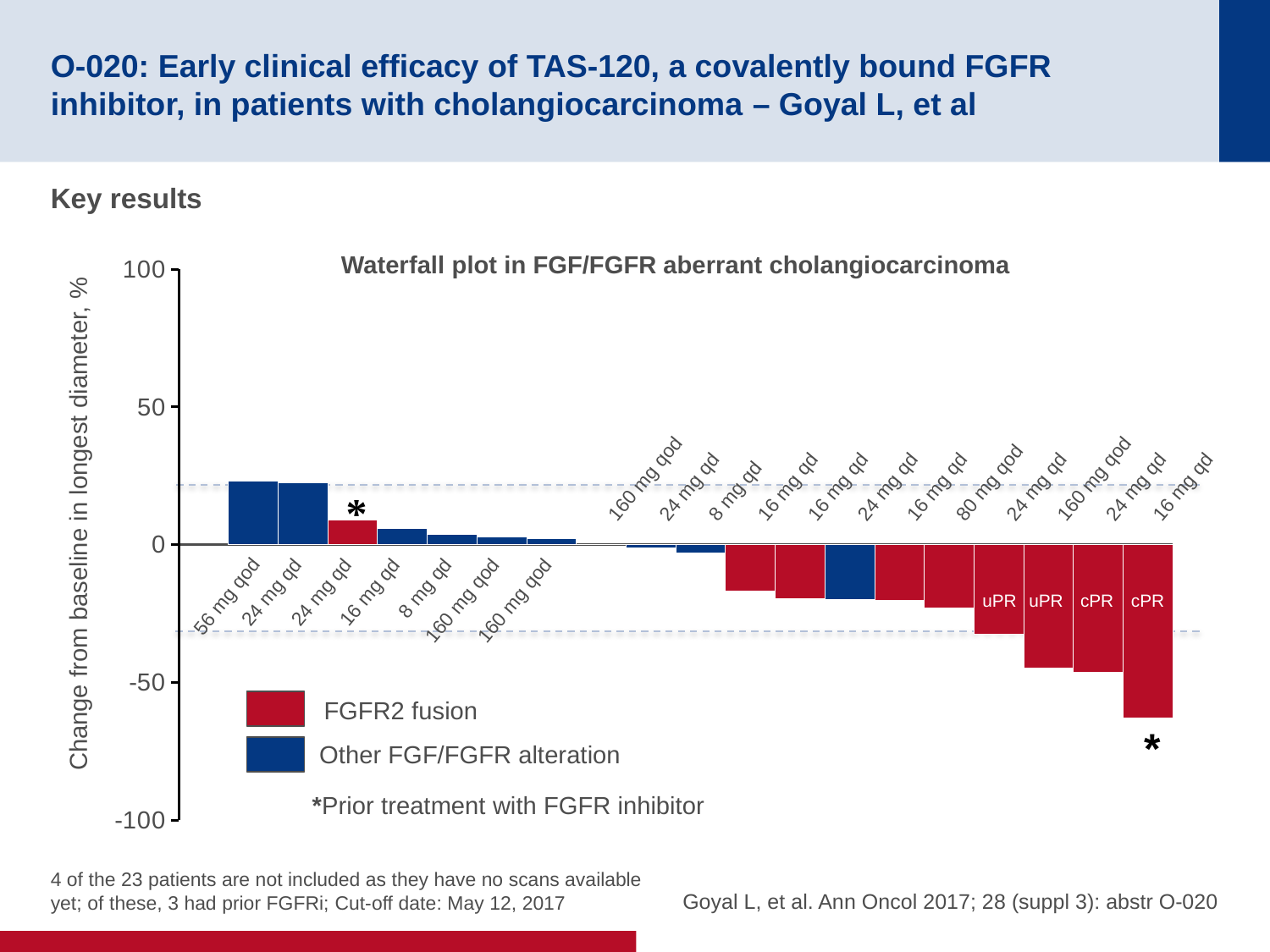
What does the red colour in the chart represent? FGFR2 fusion How many bars are labelled uPR? 2 Do the bar values rise or fall moving from left to right along the x axis? fall Is the value of the first bar, labelled 56 mg qod, greater or less than 50? less How many bars show an increase from baseline (values above 0)? 7 What is the title of the chart? Waterfall plot in FGF/FGFR aberrant cholangiocarcinoma How many entries does the legend of the waterfall plot list? 2 What type of chart is shown on the slide? Bar chart (waterfall plot) Which response label appears on the bar with the largest decrease from baseline? cPR How many bars are labelled cPR? 2